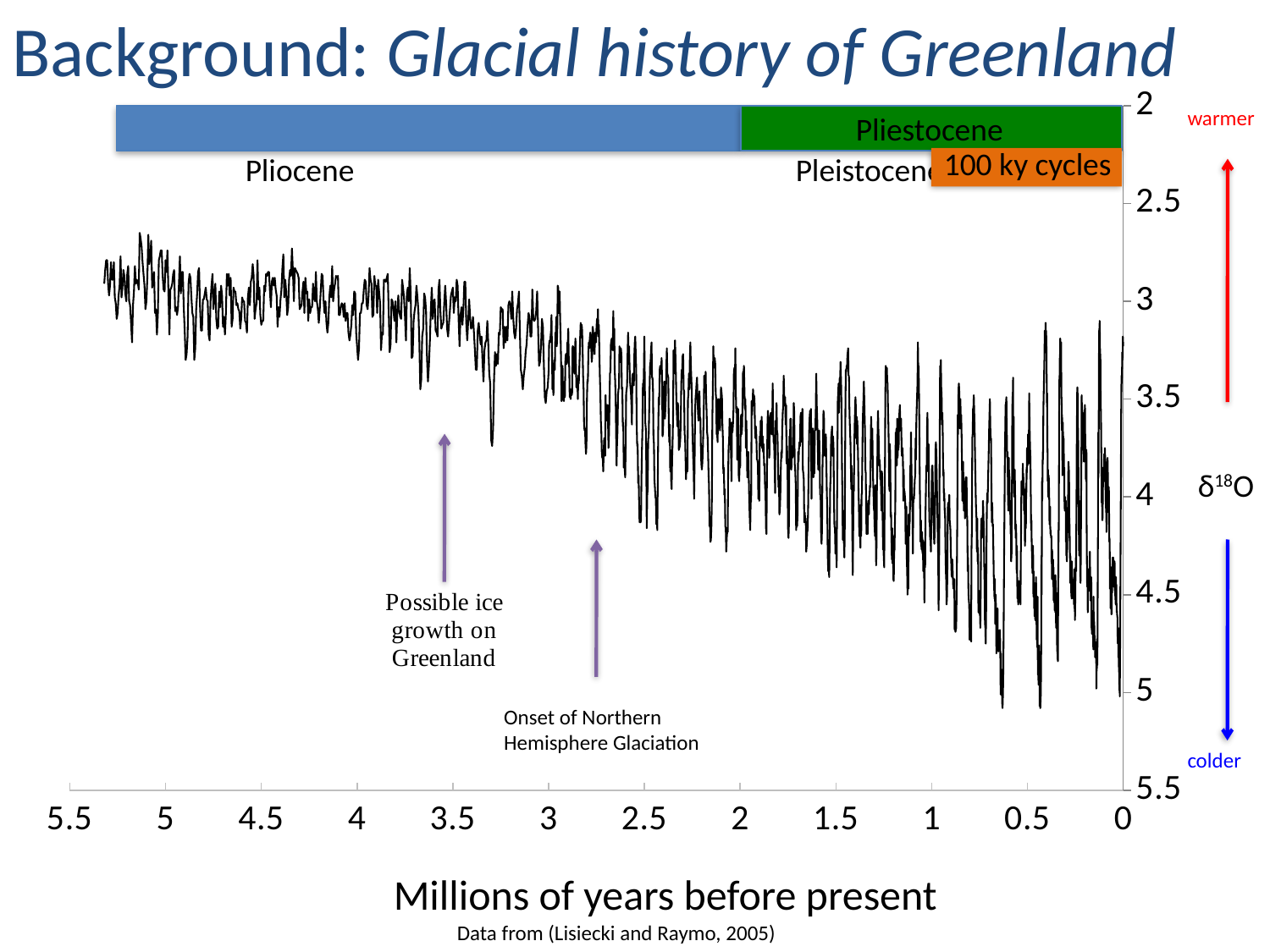
Is the δ18O value at 5 million years before present greater or less than 4? less How many data series are plotted in the chart? 1 Is the highest δ18O value reached within the last 1 million years greater or less than 4.5? greater What kind of chart is shown on the slide? line chart What is the value at the top of the y axis? 2 What is the title of the x axis of the chart? Millions of years before present Do the δ18O values generally increase or decrease numerically from 5.5 million years ago toward the present? increase What is the value at the bottom of the y axis? 5.5 What is the leftmost value labeled on the x axis? 5.5 What is the rightmost value labeled on the x axis? 0 How many labeled tick marks are there on the x axis? 12 What quantity is plotted on the y axis of the chart? δ18O